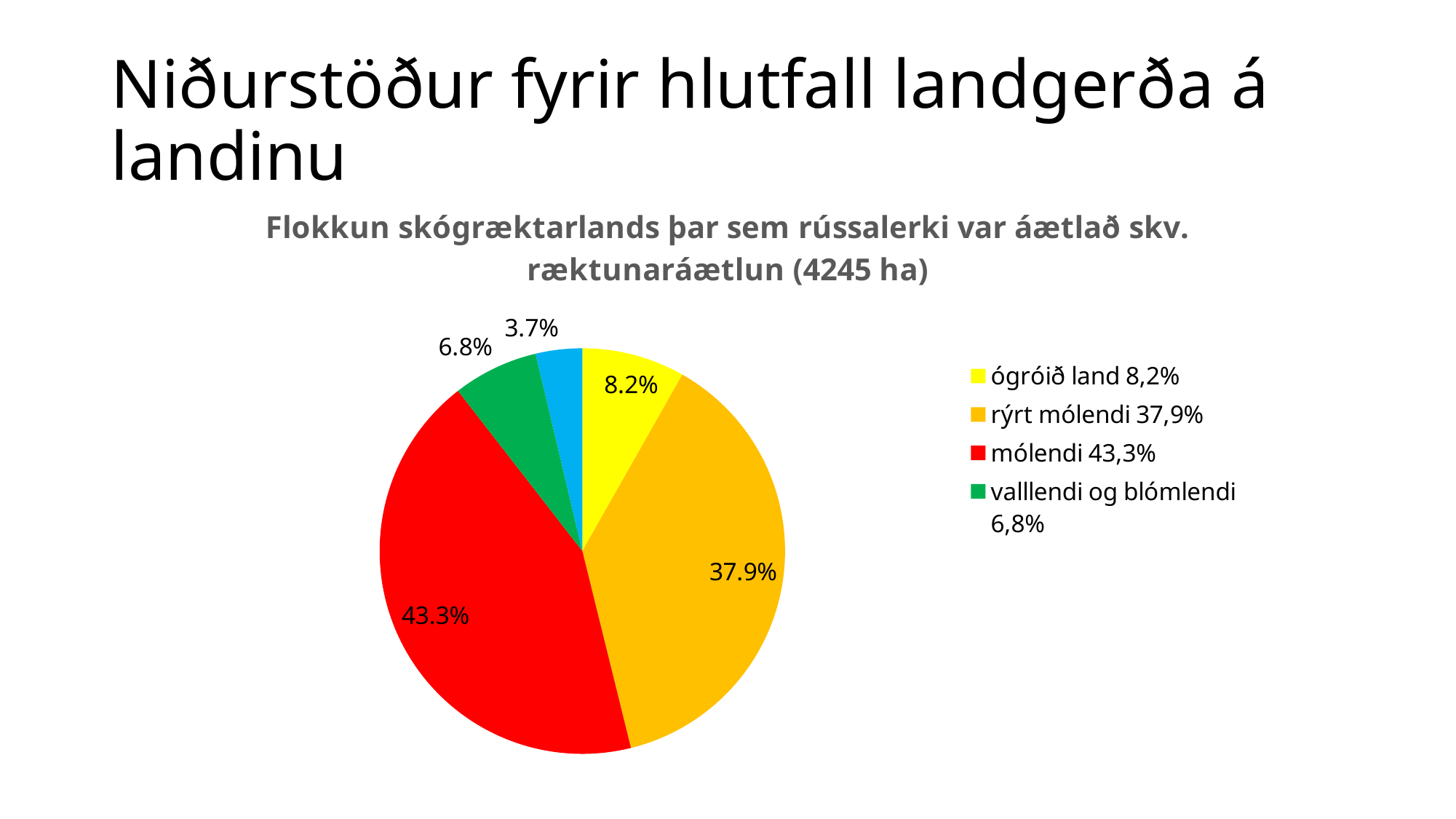
Which category has the largest slice of the pie chart? mólendi Which is larger, the slice for ógróið land or the slice for valllendi og blómlendi? ógróið land Which of the legend categories has the smallest slice of the pie chart? valllendi og blómlendi What is the share for rýrt mólendi in the pie chart? 37.9% How many entries does the legend list? 4 What kind of chart is shown on the slide? pie chart What is the share for valllendi og blómlendi in the pie chart? 6.8% What colour is the slice for mólendi? red How many slices does the pie chart have? 5 What is the share for mólendi in the pie chart? 43.3% What is the share for ógróið land in the pie chart? 8.2% What is the difference in percentage points between mólendi and rýrt mólendi? 5.4